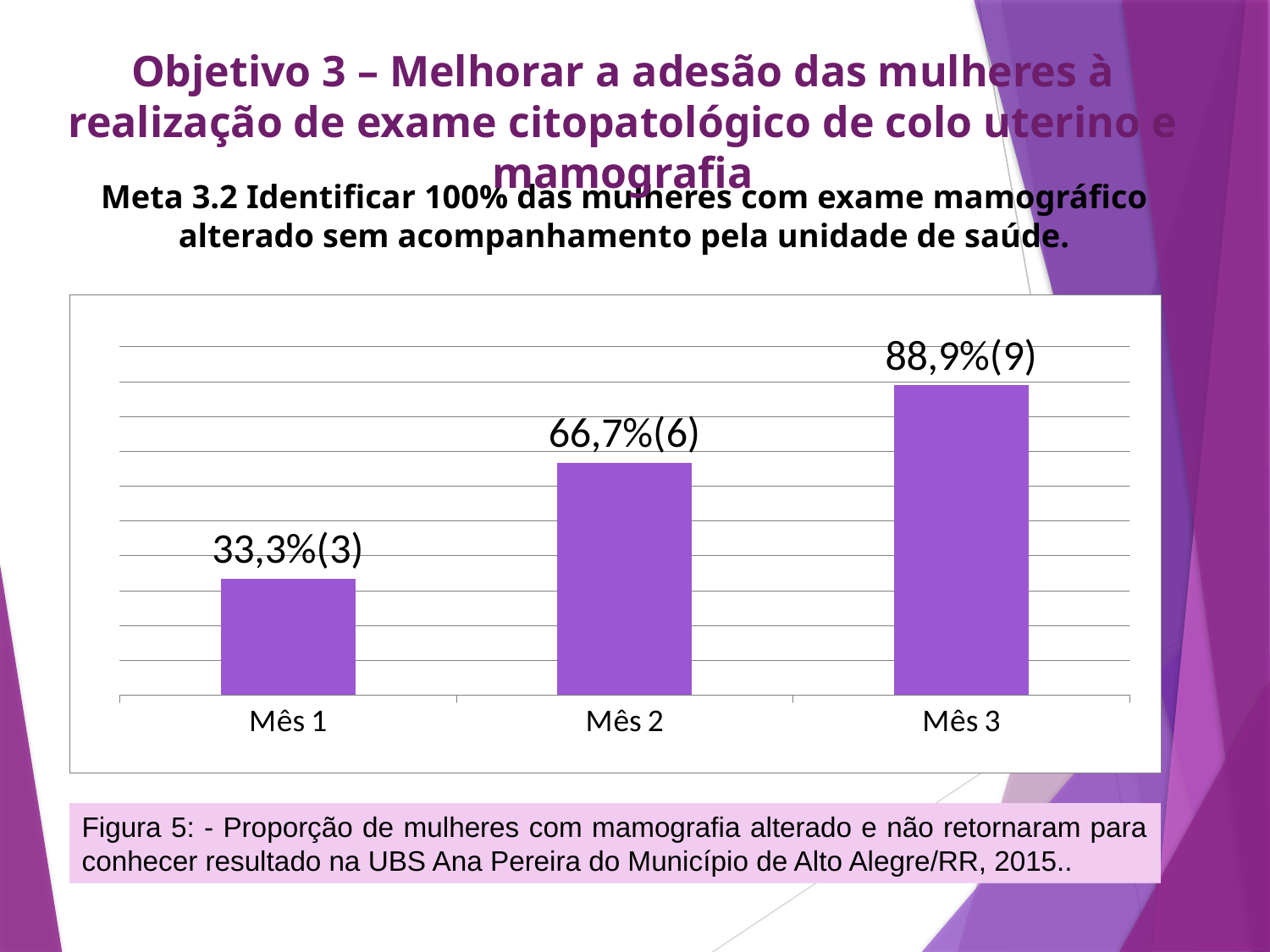
Do the values rise or fall from Mês 1 to Mês 3? Rise What is the data label shown for Mês 3? 88,9%(9) Which is larger, the value for Mês 2 or the value for Mês 3? Mês 3 What colour are the bars in the chart? Purple What kind of chart is shown on the slide? Bar chart Which month has the lowest bar? Mês 1 Which month has the highest bar? Mês 3 What is the data label shown for Mês 1? 33,3%(3) How many months (categories) are shown on the x axis? 3 What is the difference in percentage between Mês 3 and Mês 1? 55,6% What is the data label shown for Mês 2? 66,7%(6) According to the caption, which figure number is this chart? Figura 5